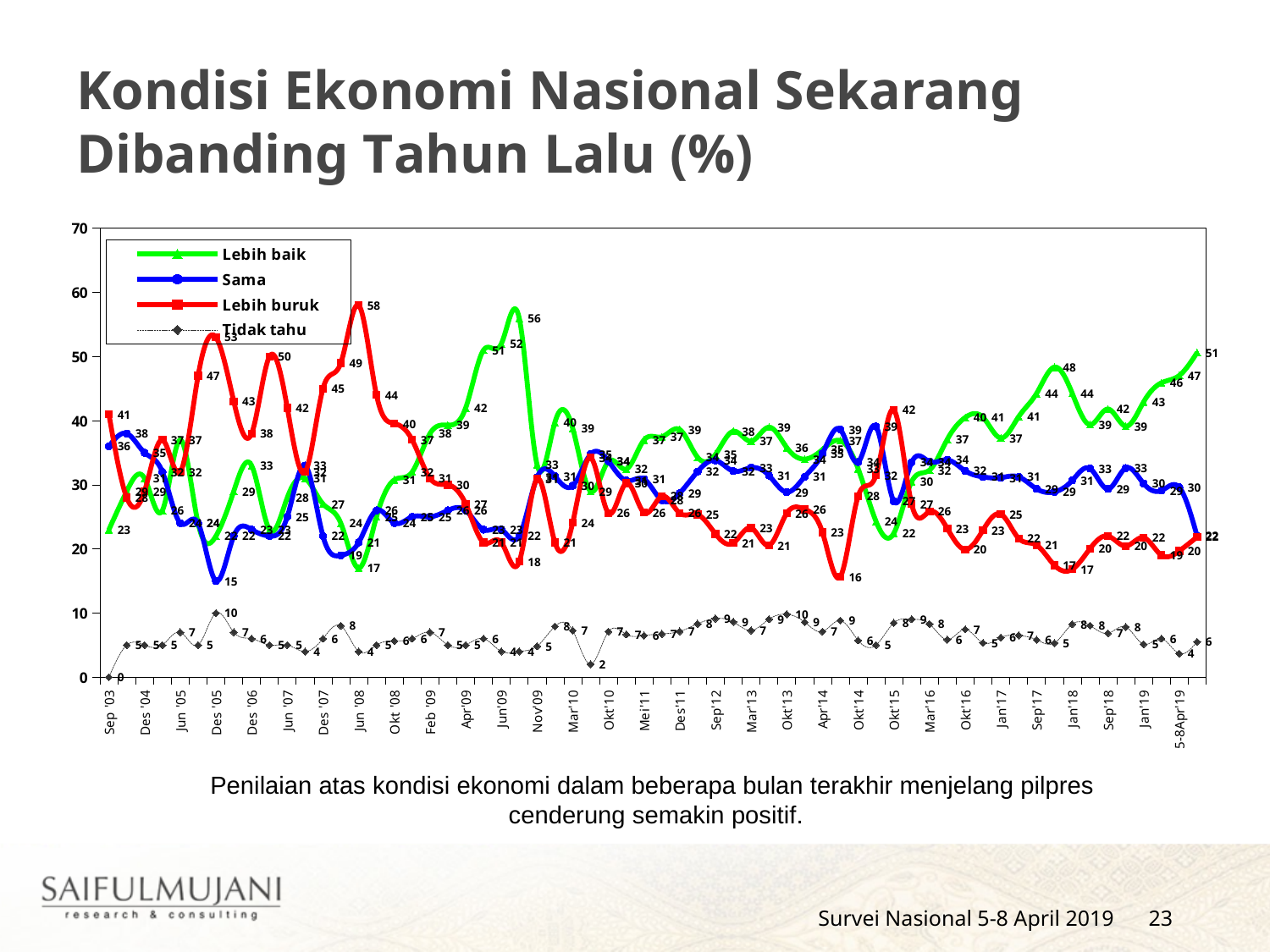
What is the value of Lebih buruk at 5-8 Apr'19? 20 What is the value of Lebih baik at 5-8 Apr'19? 47 Is the value for Lebih buruk at Jun '08 greater or less than 50? greater What are the four series named in the legend? Lebih baik, Sama, Lebih buruk, Tidak tahu What is the value of Lebih buruk at Sep '03? 41 What is the value of Tidak tahu at 5-8 Apr'19? 4 At 5-8 Apr'19, which is larger: Lebih baik or Sama? Lebih baik What is the highest value reached by the Lebih baik series? 56 How many series does the legend list? 4 What kind of chart is shown on the slide? line chart At 5-8 Apr'19, what is the difference between Lebih baik and Lebih buruk? 27 What is the highest value reached by the Lebih buruk series? 58